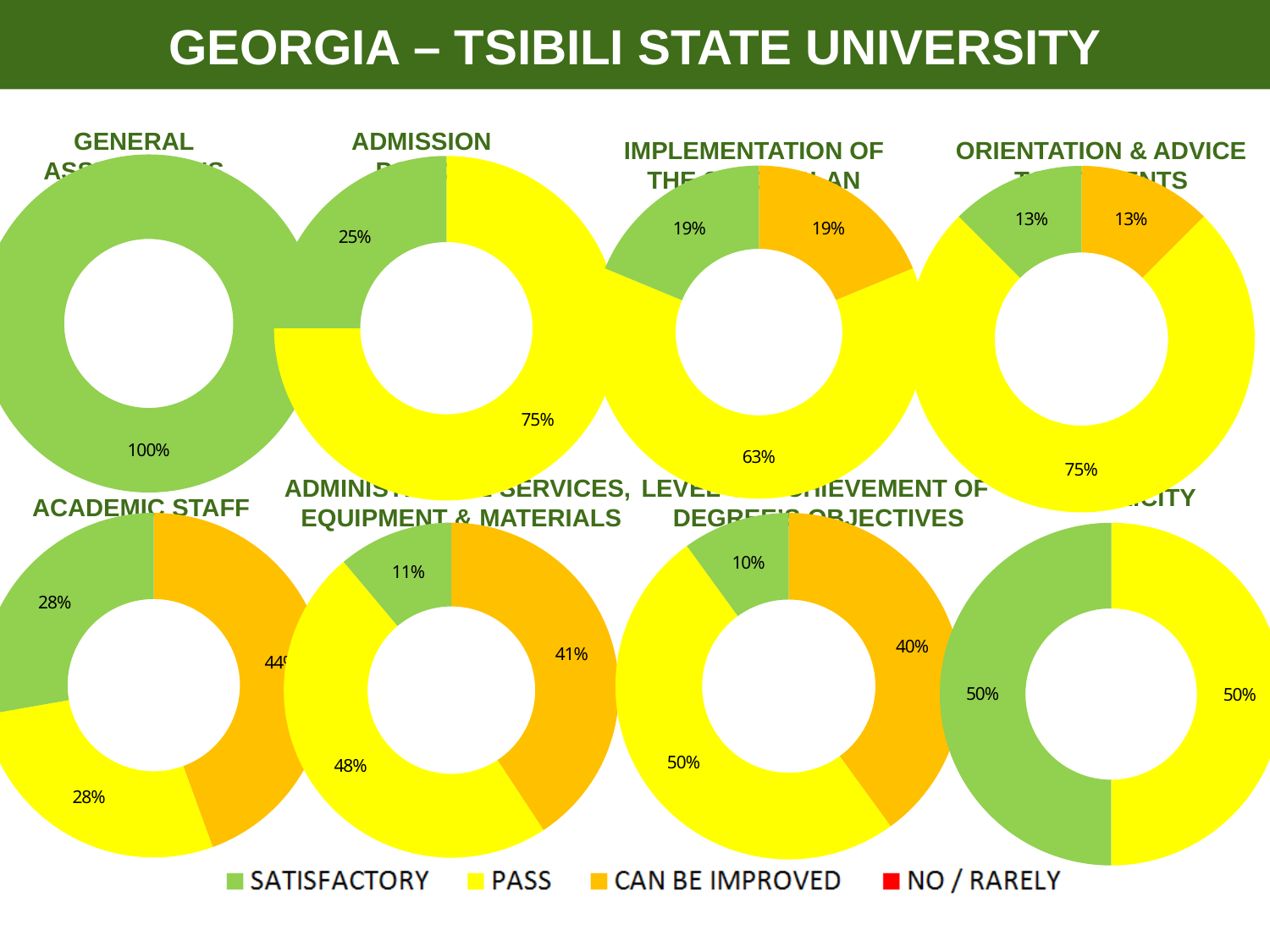
In the ACADEMIC STAFF chart, what share is SATISFACTORY (green)? 28% In the ORIENTATION & ADVICE chart, what share is CAN BE IMPROVED (orange)? 13% In the IMPLEMENTATION OF THE ... PLAN chart, what share is PASS (yellow)? 63% In the ORIENTATION & ADVICE chart, what share is PASS (yellow)? 75% In the bottom-right chart, what share is PASS (yellow)? 50% In the EQUIPMENT & MATERIALS chart, which category has the largest share? PASS In the GENERAL ASSESSMENTS chart (top left), what share is SATISFACTORY (green)? 100% In the ACADEMIC STAFF chart, what share is PASS (yellow)? 28% In the ADMISSION chart, what share is SATISFACTORY (green)? 25% What kind of chart is used for the ACADEMIC STAFF data on the slide? Donut (pie) chart How many series does the legend at the bottom of the slide list? 4 In the EQUIPMENT & MATERIALS chart, what is the difference between the PASS share and the CAN BE IMPROVED share? 7%